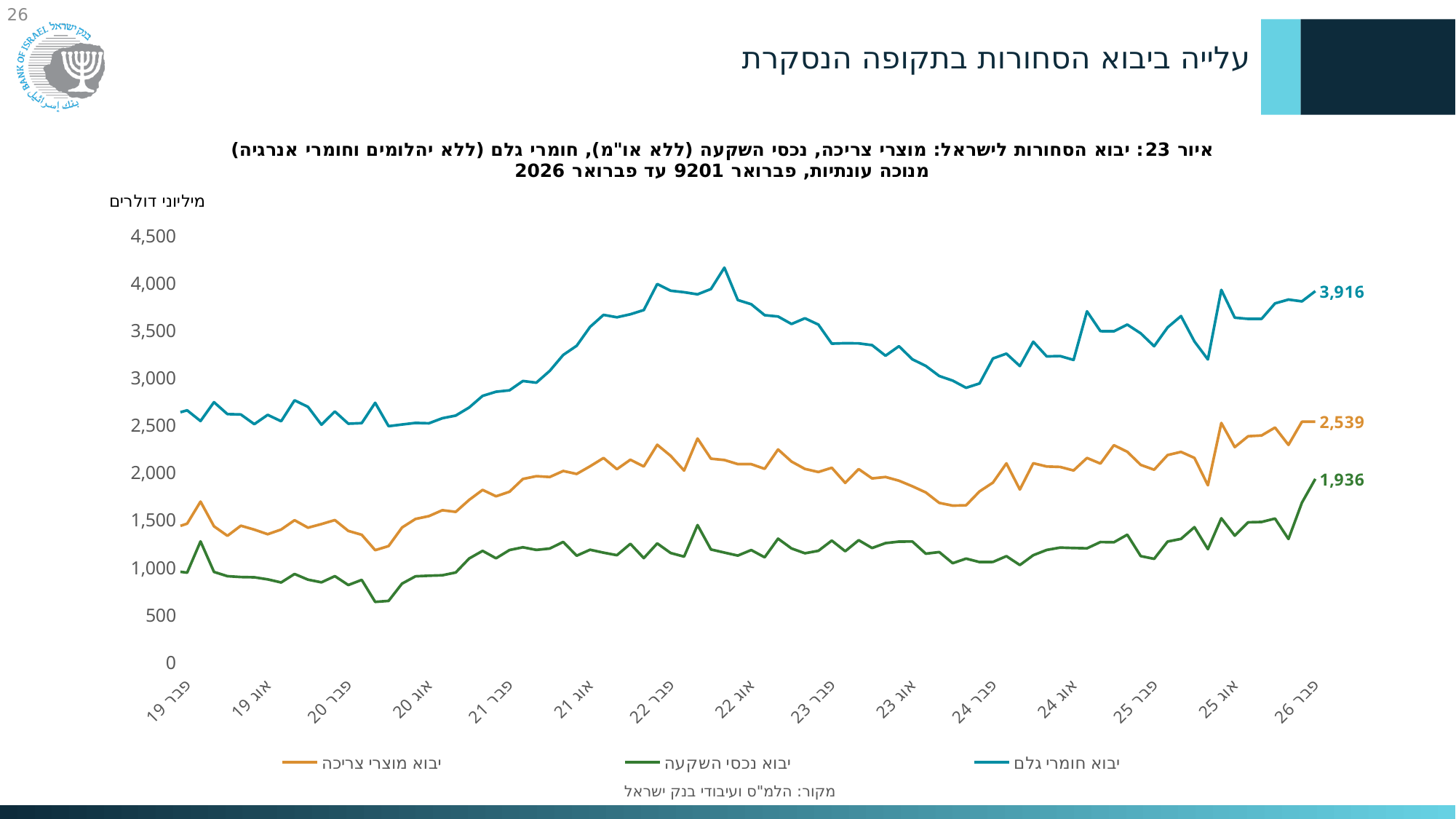
How many series does the legend list? 3 Is the value of יבוא נכסי השקעה in February 2019 greater or less than 1,500? less What unit is shown on the y axis of the chart? מיליוני דולרים What is the final labelled value of the יבוא חומרי גלם series (February 2026)? 3,916 What type of chart is shown on the slide? line chart Which series has the highest value at the end of the period (February 2026)? יבוא חומרי גלם What is the final labelled value of the יבוא מוצרי צריכה series (February 2026)? 2,539 What is the difference between the final labelled values of יבוא חומרי גלם and יבוא מוצרי צריכה? 1,377 Does the יבוא חומרי גלם series rise or fall overall from February 2019 to February 2026? rise Which series has the lowest value at the end of the period (February 2026)? יבוא נכסי השקעה What is the final labelled value of the יבוא נכסי השקעה series (February 2026)? 1,936 What is the difference between the final labelled values of יבוא מוצרי צריכה and יבוא נכסי השקעה? 603